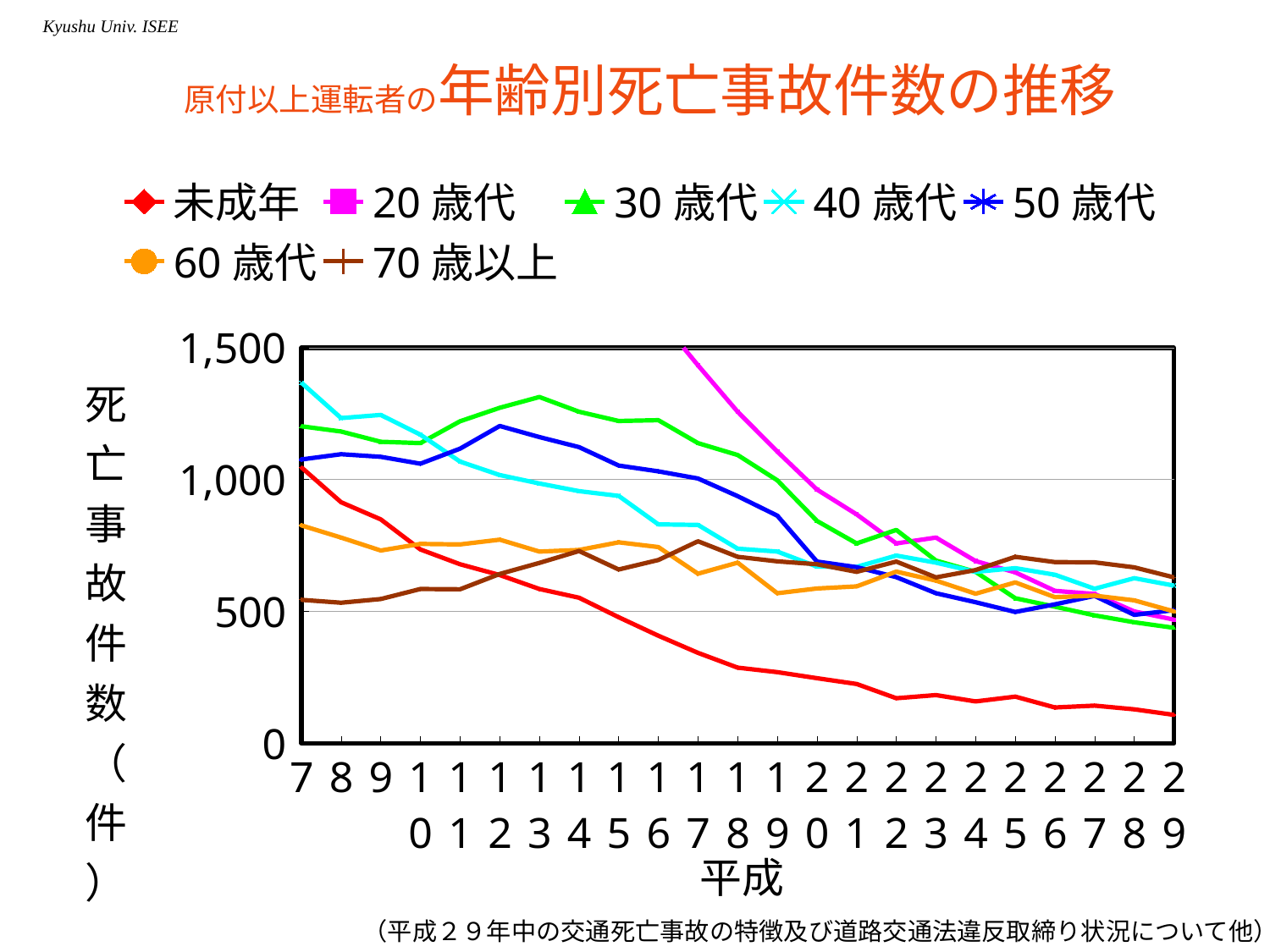
How many series does the legend list? 7 Does the 未成年 series rise or fall from 平成 7 to 平成 29? fall Is the value for 未成年 in 平成 29 greater or less than 500? less What is the label of the y axis? 死亡事故件数（件） What kind of chart is shown on the slide? line chart How many years (平成 7 to 平成 29) are plotted along the x axis? 23 Which series has the lowest value in 平成 29? 未成年 In 平成 7, which is larger: the value for 未成年 or the value for 70 歳以上? 未成年 Which series has the highest value in 平成 7? 20 歳代 Is the value for 20 歳代 in 平成 17 greater or less than 1,000? greater Is the value for 60 歳代 in 平成 7 greater or less than 500? greater